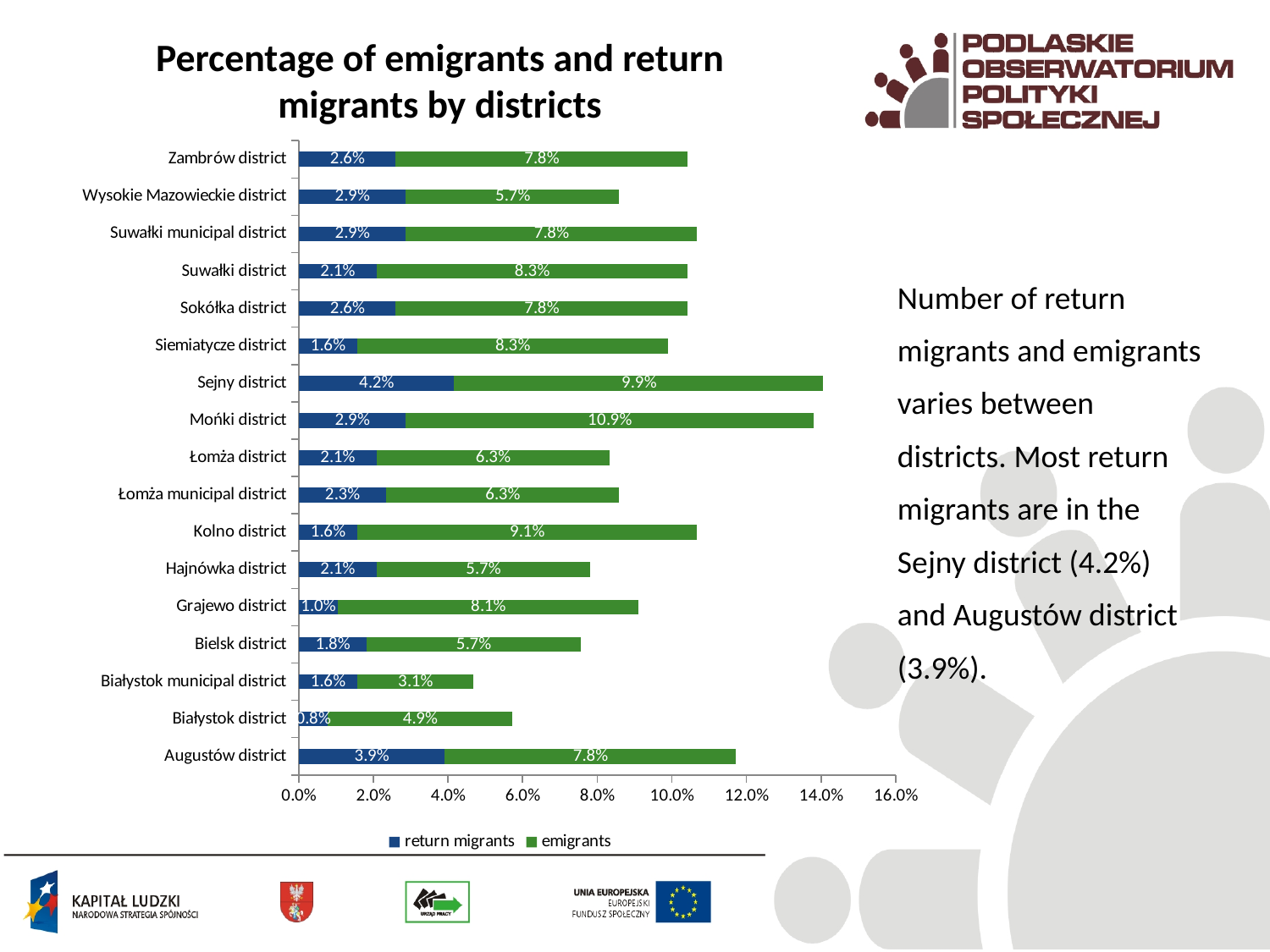
What is the percentage of emigrants in the Mońki district? 10.9% How many districts are shown in the chart? 17 What is the percentage of return migrants in the Sejny district? 4.2% Which district has the lowest percentage of return migrants? Białystok district What is the difference in percentage points between the emigrants share in the Mońki district and in the Sejny district? 1.0 percentage points How many series does the legend list? 2 What is the combined total of return migrants and emigrants for the Sejny district? 14.1% What type of chart is shown on the slide? stacked bar chart Which district has the highest percentage of emigrants? Mońki district Which is larger: the percentage of emigrants in the Kolno district or in the Grajewo district? Kolno district Which district has the highest percentage of return migrants? Sejny district What is the percentage of emigrants in the Białystok municipal district? 3.1%